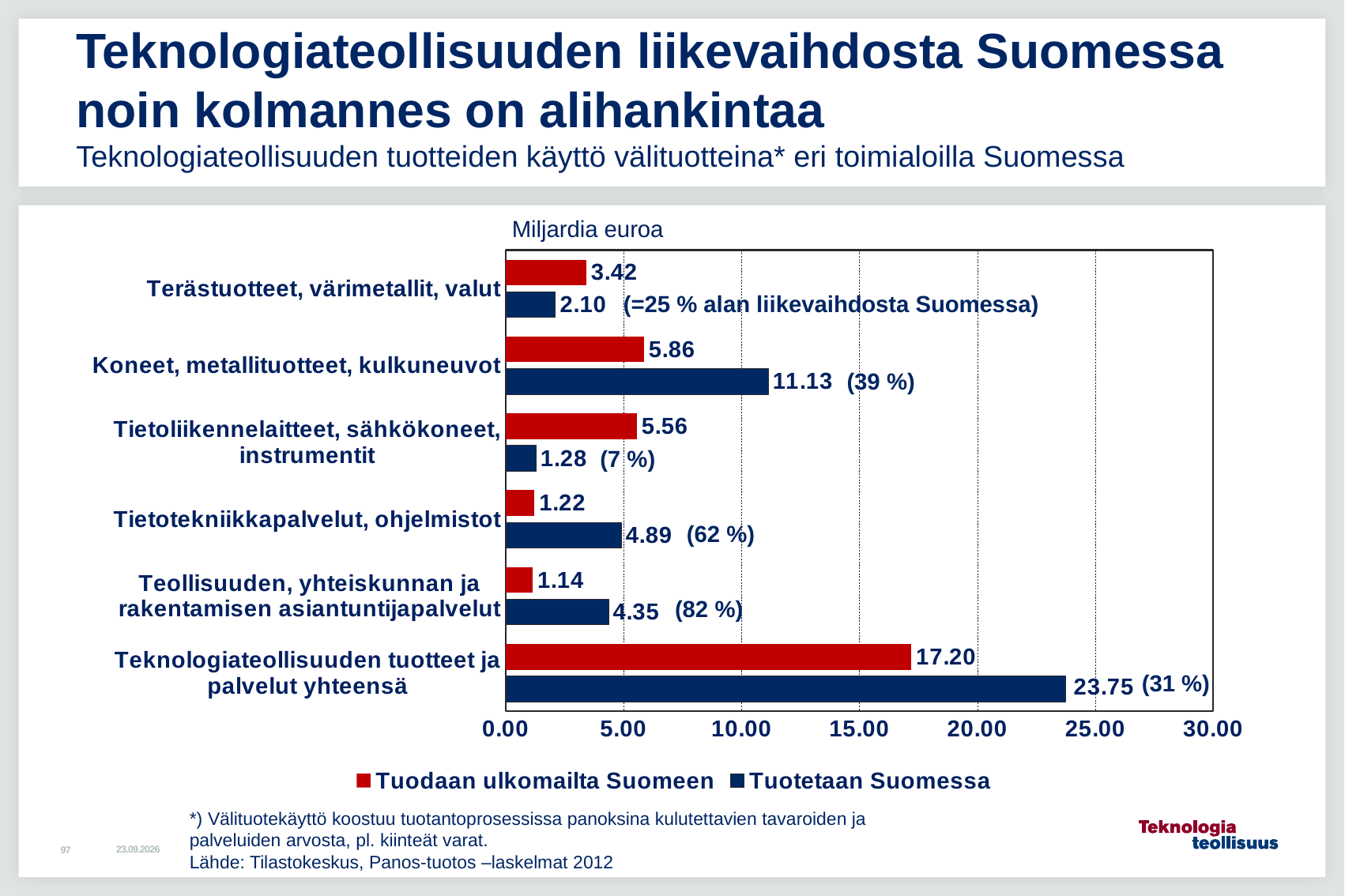
Is the value of "Tuotetaan Suomessa" for "Tietotekniikkapalvelut, ohjelmistot" greater or less than 5.00? less What is the difference between "Tuotetaan Suomessa" and "Tuodaan ulkomailta Suomeen" for "Teknologiateollisuuden tuotteet ja palvelut yhteensä"? 6.55 How many series does the legend list? 2 Which category has the lowest value for "Tuotetaan Suomessa"? Tietoliikennelaitteet, sähkökoneet, instrumentit How many categories are shown on the chart? 6 What is the value of "Tuodaan ulkomailta Suomeen" for "Tietoliikennelaitteet, sähkökoneet, instrumentit"? 5.56 What kind of chart is shown on the slide? bar chart What unit is shown above the chart? Miljardia euroa For "Terästuotteet, värimetallit, valut", which is larger: "Tuodaan ulkomailta Suomeen" or "Tuotetaan Suomessa"? Tuodaan ulkomailta Suomeen What is the value of "Tuotetaan Suomessa" for "Koneet, metallituotteet, kulkuneuvot"? 11.13 Which category has the highest value for "Tuodaan ulkomailta Suomeen"? Teknologiateollisuuden tuotteet ja palvelut yhteensä What is the value of "Tuotetaan Suomessa" for "Teollisuuden, yhteiskunnan ja rakentamisen asiantuntijapalvelut"? 4.35